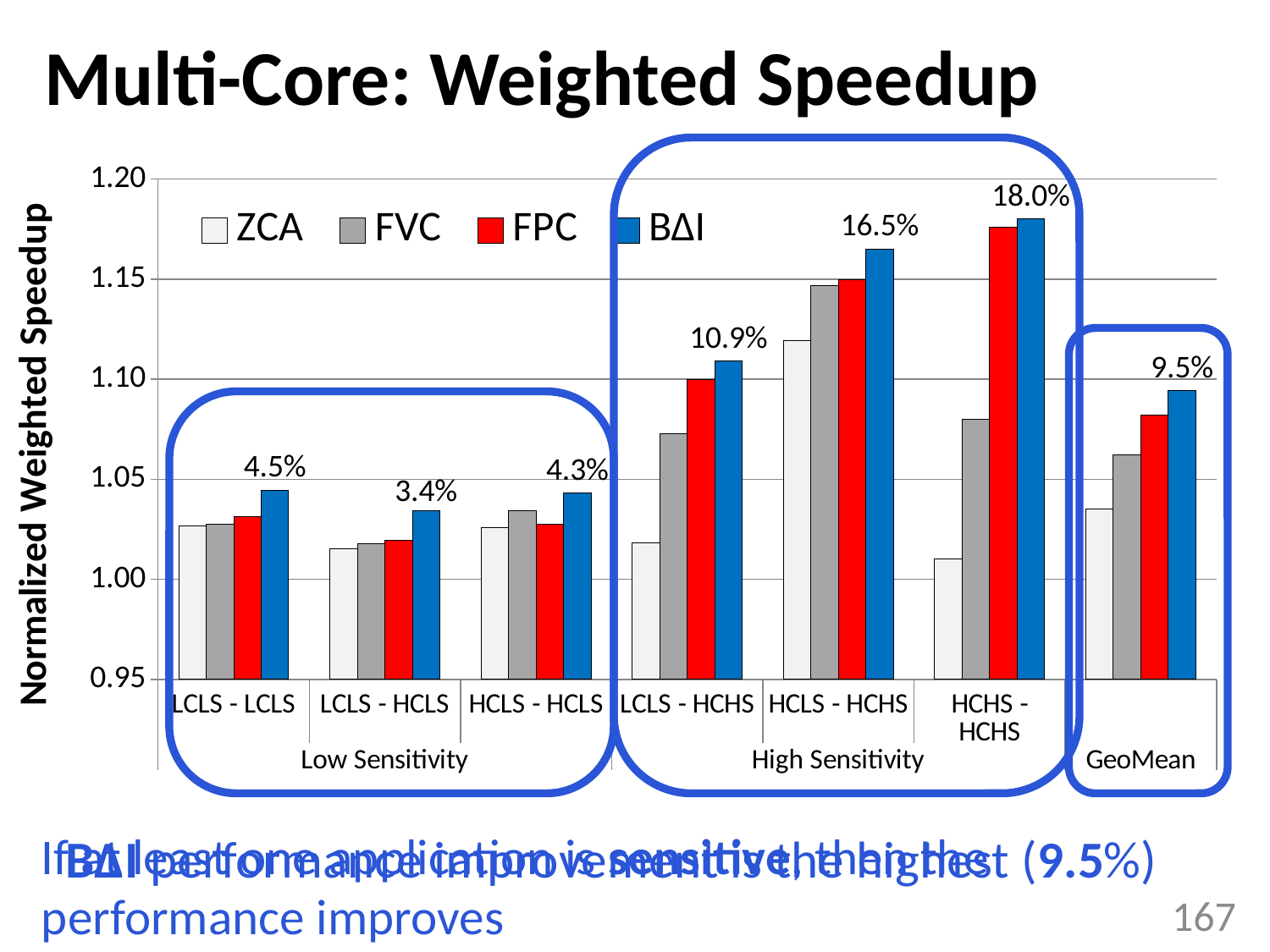
How many series does the legend list? 4 Is the ZCA value for HCHS - HCHS greater or less than 1.05? less Which category has the highest BΔI bar? HCHS - HCHS What percentage label is printed above the BΔI bar for LCLS - HCLS? 3.4% What is the title of the y axis? Normalized Weighted Speedup What percentage label is printed above the BΔI bar for HCHS - HCHS? 18.0% Which category has the lowest BΔI bar? LCLS - HCLS What kind of chart is shown on the slide? bar chart Is the BΔI value for HCHS - HCHS greater or less than 1.15? greater For HCHS - HCHS, which is larger, the FVC bar or the FPC bar? FPC How many workload categories are plotted along the x axis? 7 What percentage label is printed above the BΔI bar for GeoMean? 9.5%